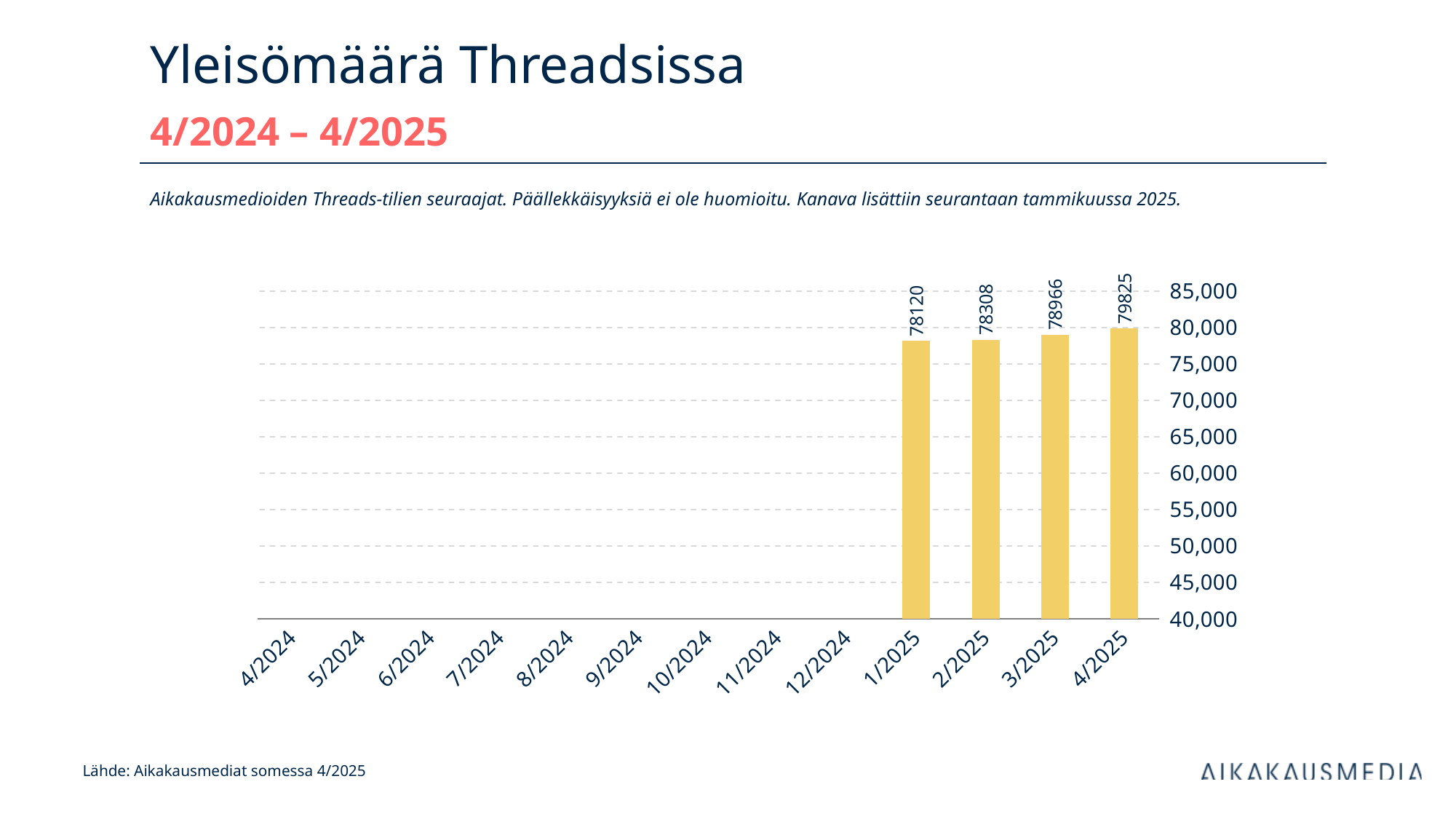
Which is larger, the value for 3/2025 or the value for 4/2025? 4/2025 What kind of chart is shown? Bar chart Among the months with a bar, which has the lowest value? 1/2025 Which month has the highest value? 4/2025 What is the value for 1/2025? 78120 What is the value for 3/2025? 78966 What is the difference between the values for 4/2025 and 1/2025? 1705 How many months are labelled on the x axis? 13 How many months have a bar plotted? 4 What is the difference between the values for 3/2025 and 2/2025? 658 What is the value for 2/2025? 78308 What is the value for 4/2025? 79825